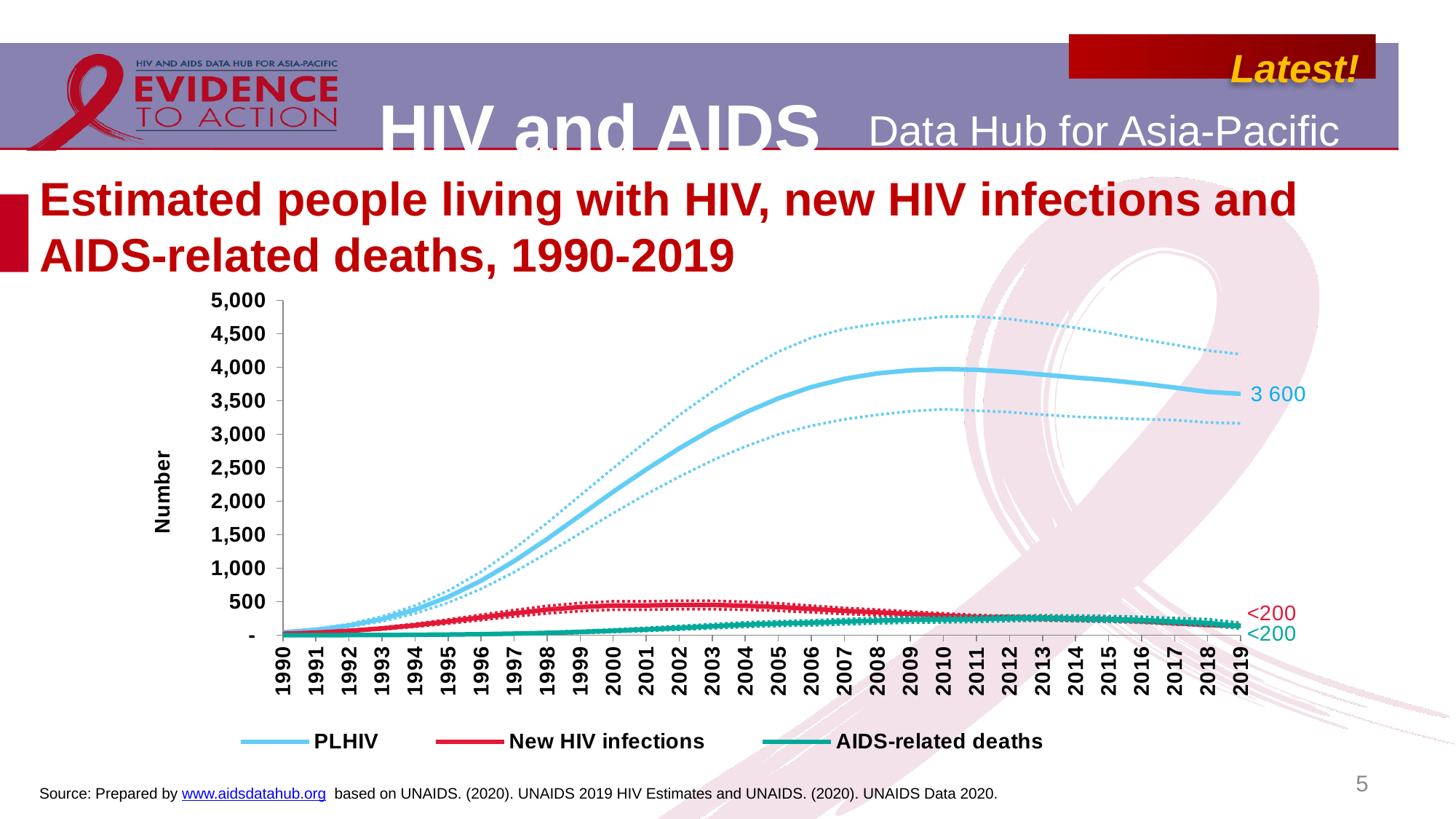
What is the title of the y axis? Number Does the PLHIV line rise or fall between 2010 and 2019? Fall What kind of chart is shown on the slide? Line chart How many years are shown on the x axis? 30 What is the labelled value of PLHIV in 2019? 3 600 Is the value for PLHIV in 1995 greater or less than 1,000? less What is the labelled value of AIDS-related deaths in 2019? <200 Is the value for PLHIV in 2010 greater or less than 3,500? greater How many series does the legend list? 3 Which series has the highest value in 2019? PLHIV What is the labelled value of New HIV infections in 2019? <200 Does the PLHIV line rise or fall between 1990 and 2010? Rise